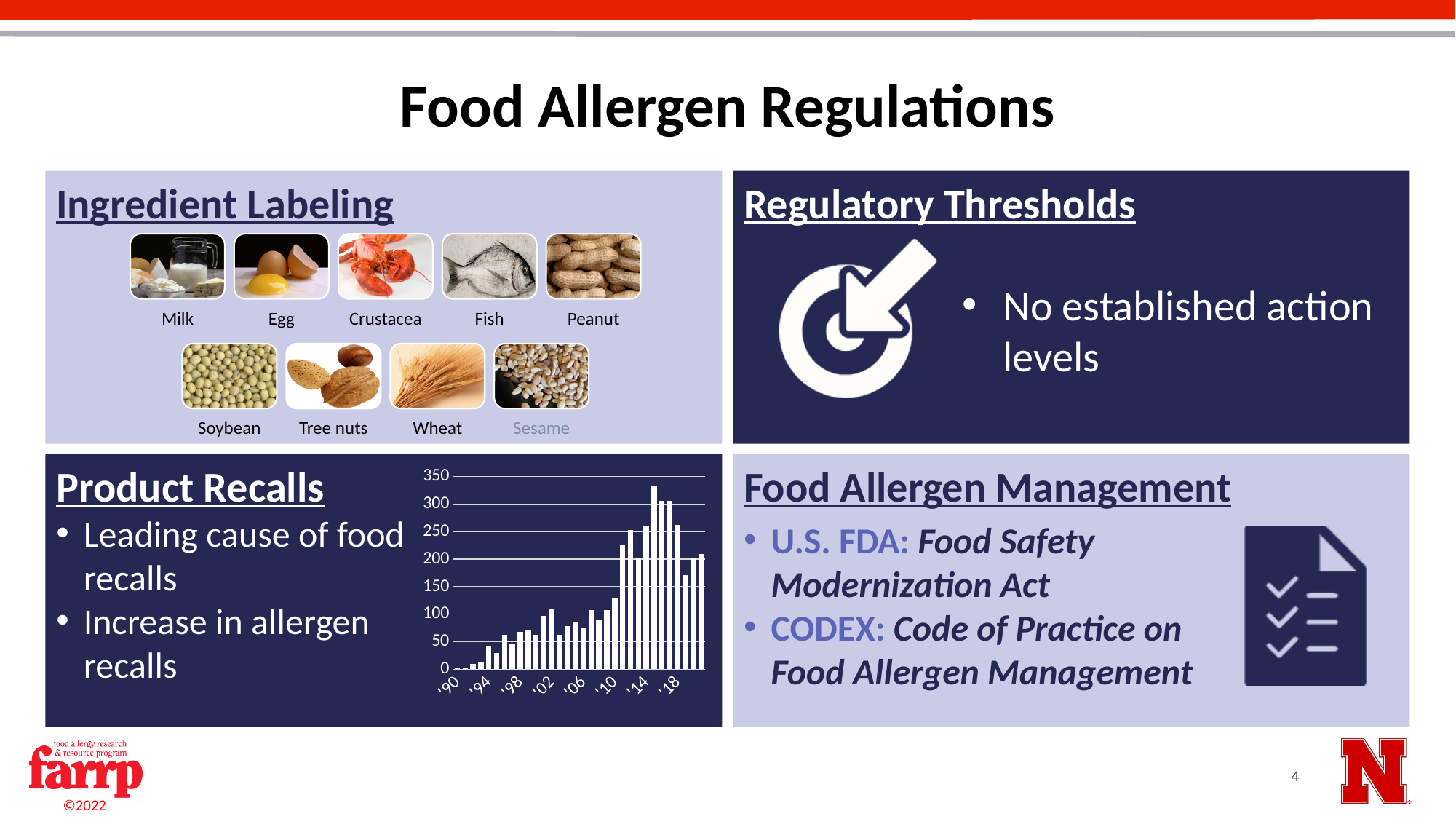
What is the highest value shown on the y axis of the Product Recalls chart? 350 What kind of chart is shown in the Product Recalls panel? bar chart In the Product Recalls chart, is the value for '90 greater or less than 50? less In the Product Recalls chart, is the value for '18 greater or less than 100? greater In the Product Recalls chart, do the values generally rise or fall from '90 to '18? rise In the Product Recalls chart, is the value for '90 larger or smaller than the value for '14? smaller How many year labels are shown on the x axis of the Product Recalls chart? 8 What is the first year label on the x axis of the Product Recalls chart? '90 In the Product Recalls chart, is the value for '14 greater or less than 150? greater